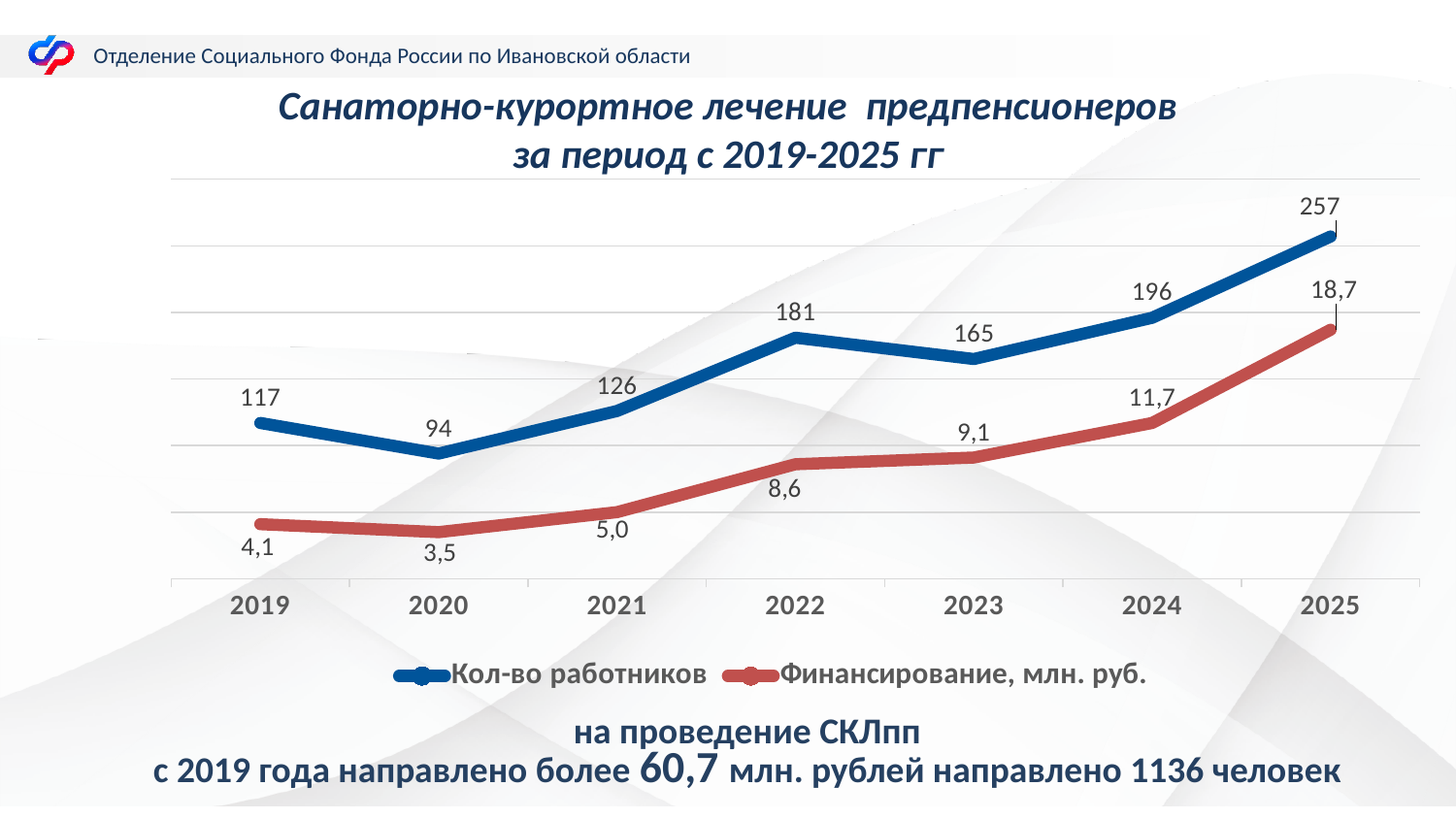
In which year is 'Кол-во работников' lowest? 2020 What is the value of 'Кол-во работников' in 2025? 257 What is the value of 'Кол-во работников' in 2022? 181 Does 'Финансирование, млн. руб.' rise or fall from 2021 to 2025? Rise What is the difference between 'Кол-во работников' in 2024 and in 2023? 31 How many years are shown on the x axis? 7 What colour is the line for 'Кол-во работников'? Blue In which year is 'Финансирование, млн. руб.' highest? 2025 How many series does the legend list? 2 Which is larger: 'Кол-во работников' in 2022 or in 2023? 2022 What kind of chart is shown on the slide? Line chart What is the value of 'Финансирование, млн. руб.' in 2020? 3,5